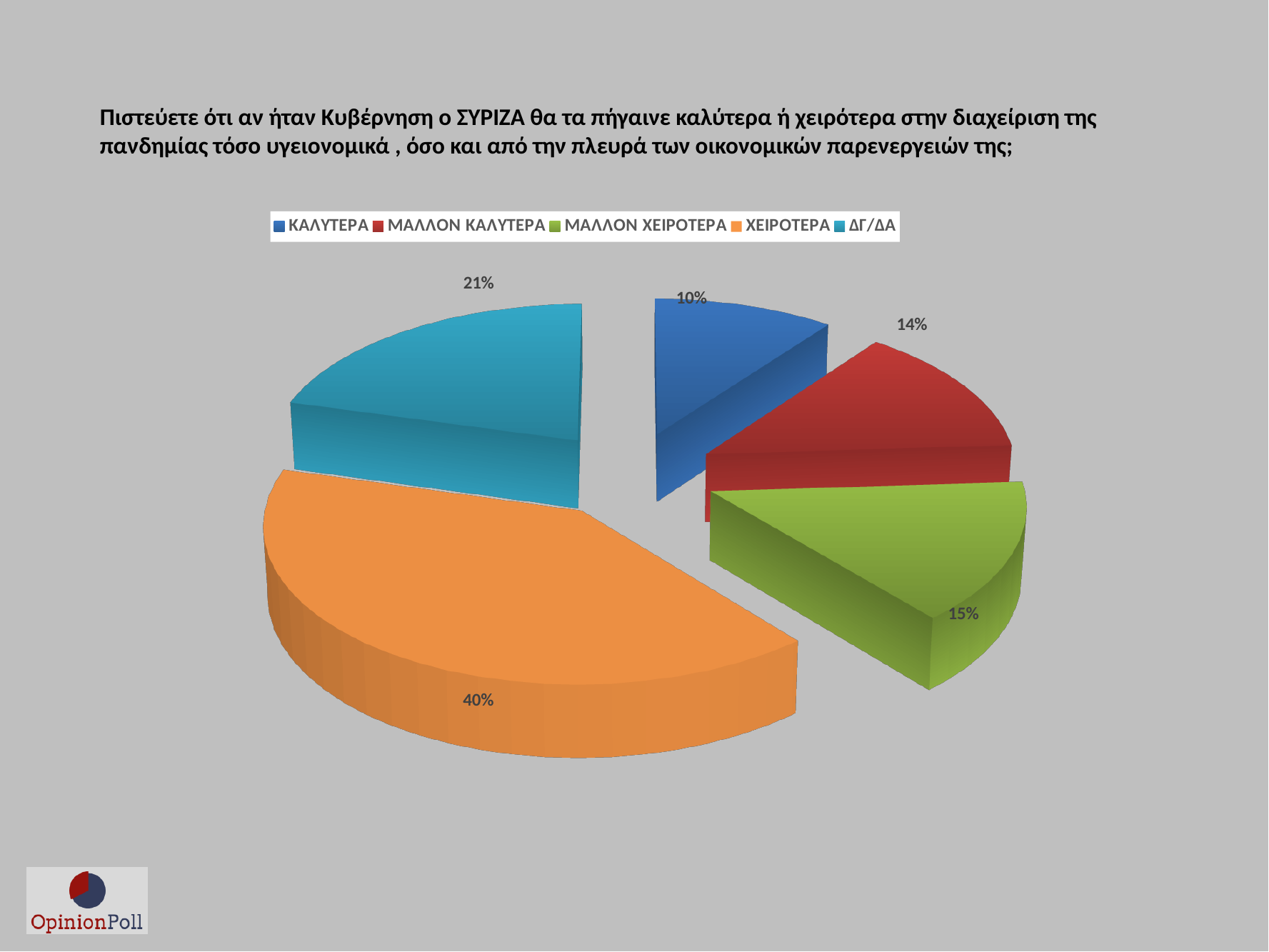
What percentage of the pie is ΧΕΙΡΟΤΕΡΑ? 40% What percentage of the pie is ΜΑΛΛΟΝ ΚΑΛΥΤΕΡΑ? 14% What is the difference in percentage points between ΧΕΙΡΟΤΕΡΑ and ΔΓ/ΔΑ? 19 What colour is the ΧΕΙΡΟΤΕΡΑ slice? orange What kind of chart is shown on the slide? pie chart Which is larger, ΜΑΛΛΟΝ ΚΑΛΥΤΕΡΑ or ΔΓ/ΔΑ? ΔΓ/ΔΑ What percentage of the pie is ΚΑΛΥΤΕΡΑ? 10% What percentage of the pie is ΜΑΛΛΟΝ ΧΕΙΡΟΤΕΡΑ? 15% Which category has the smallest share of the pie? ΚΑΛΥΤΕΡΑ What percentage of the pie is ΔΓ/ΔΑ? 21% How many slices does the pie chart have? 5 Which category has the largest share of the pie? ΧΕΙΡΟΤΕΡΑ